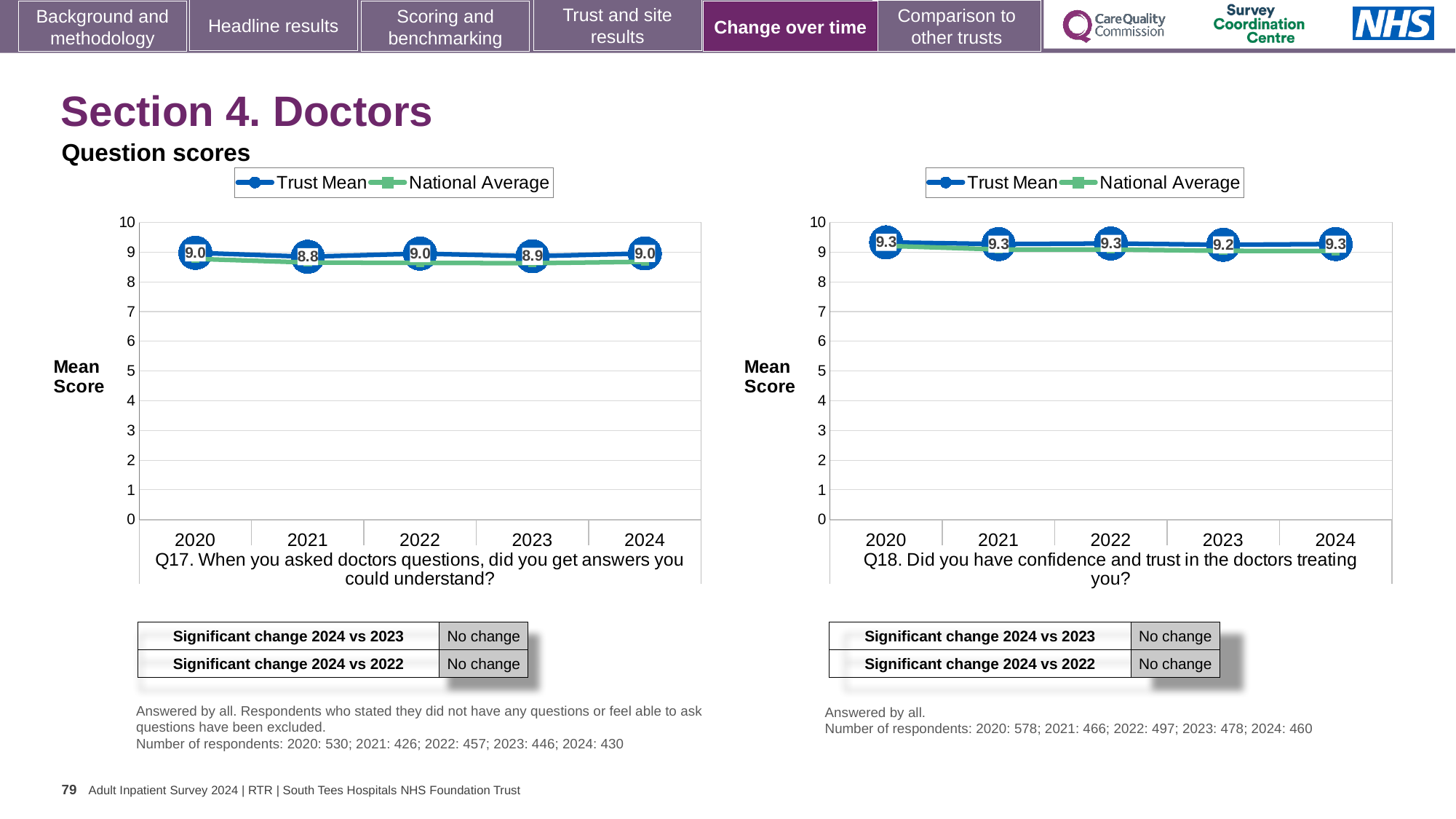
In the Q18 chart, which year has the lowest Trust Mean score? 2023 In the Q17 chart, which year has the lowest Trust Mean score? 2021 In the Q18 chart, what is the difference between the Trust Mean scores for 2024 and 2023? 0.1 In the Q17 chart, what is the Trust Mean score for 2024? 9.0 In the Q17 chart, is the Trust Mean score for 2023 larger than the Trust Mean score for 2021? Yes How many years are shown on the x axis of the Q18 chart? 5 In the Q18 chart, what is the Trust Mean score for 2020? 9.3 What type of chart is used for Q18? Line chart In the Q18 chart, what is the Trust Mean score for 2023? 9.2 How many series does the legend of the Q17 chart list? 2 In the Q17 chart, what is the Trust Mean score for 2021? 8.8 In the Q17 chart, what is the difference between the Trust Mean scores for 2022 and 2021? 0.2